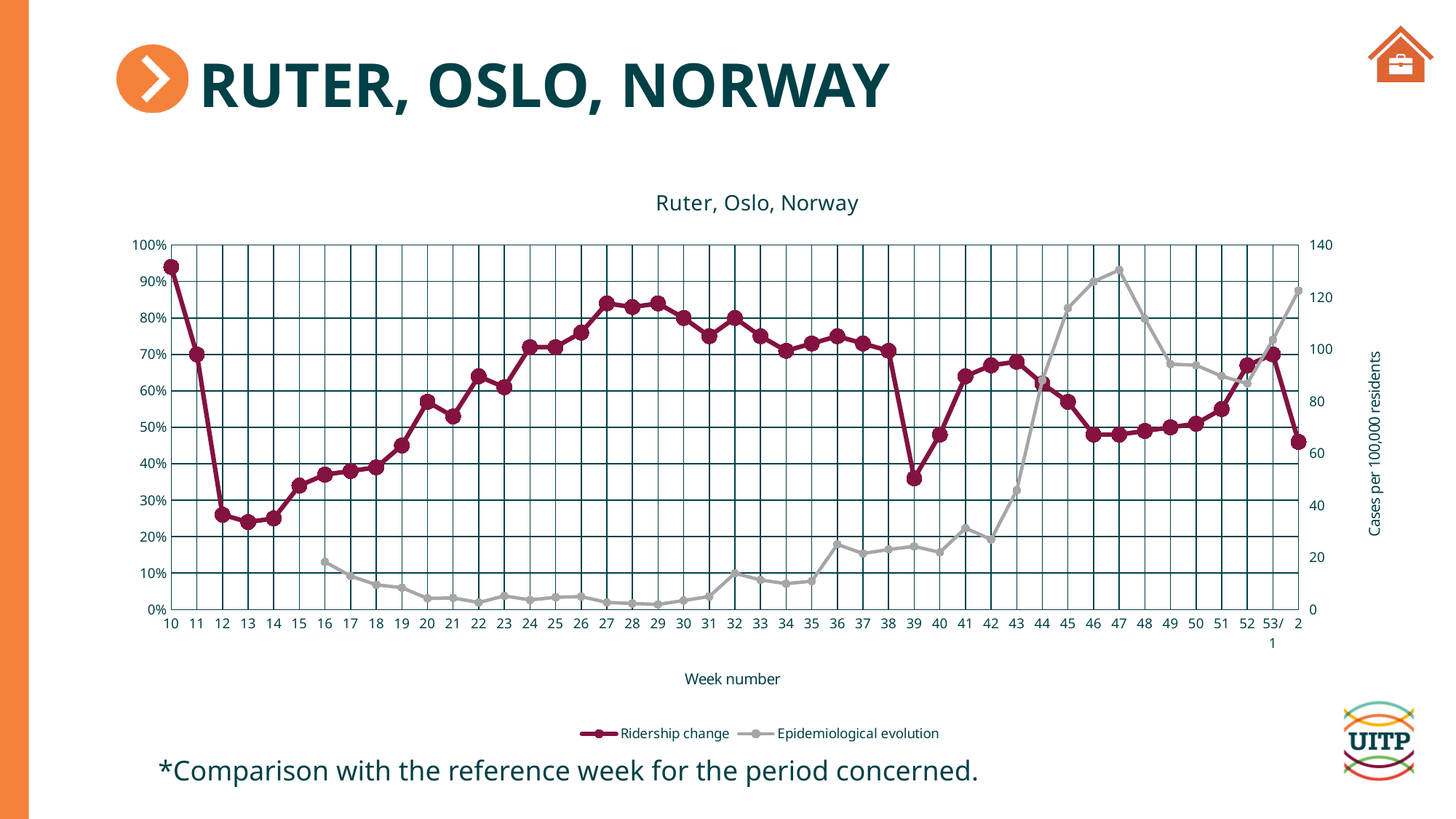
How many series does the legend list? 2 Does the Epidemiological evolution series rise or fall between week 43 and week 47? Rise Is the Ridership change value for week 10 greater or less than 90%? greater What is the title of the chart? Ruter, Oslo, Norway Is the Epidemiological evolution value for week 43 greater or less than 60? less In which week does the Epidemiological evolution series reach its highest value? 47 Is the Ridership change value for week 39 greater or less than 40%? less Which week has the larger Ridership change value, week 10 or week 12? Week 10 What kind of chart is shown on the slide? Line chart What is the label of the right-hand vertical axis? Cases per 100,000 residents Does the Ridership change series rise or fall between week 10 and week 12? Fall